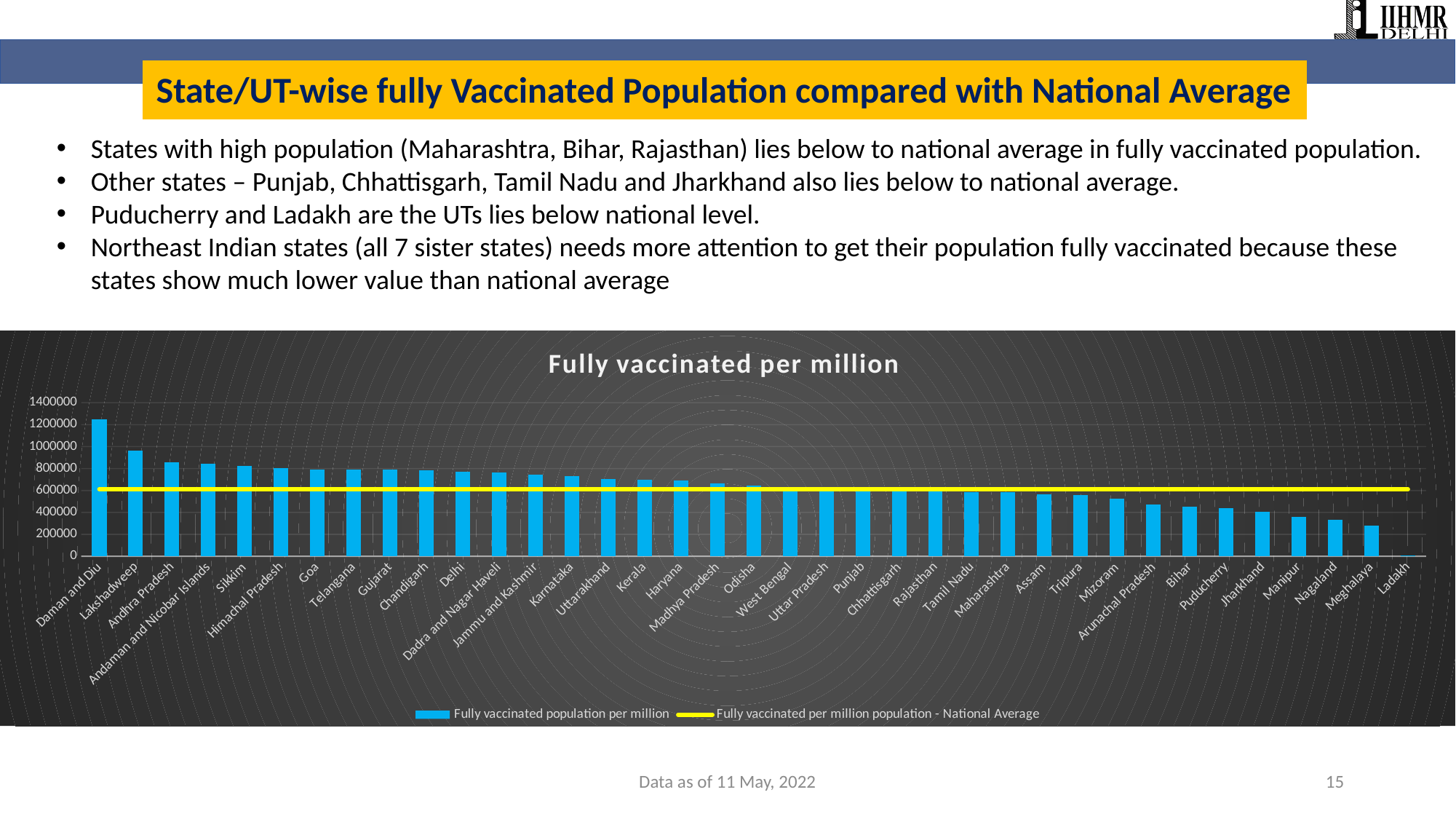
Do the bar values rise or fall moving from left to right along the x axis? Fall What does the yellow line in the chart represent? Fully vaccinated per million population - National Average Is the value for Lakshadweep greater or less than 1000000? less Is the value for Bihar greater or less than 600000? less Which state/UT has the highest fully vaccinated population per million? Daman and Diu How many series does the chart legend list? 2 What is the title of the chart? Fully vaccinated per million Is the value for Daman and Diu greater or less than 1000000? greater Which has a higher fully vaccinated population per million, Sikkim or Bihar? Sikkim Which state/UT has the lowest fully vaccinated population per million? Ladakh What kind of chart is shown on the slide? Combination bar and line chart